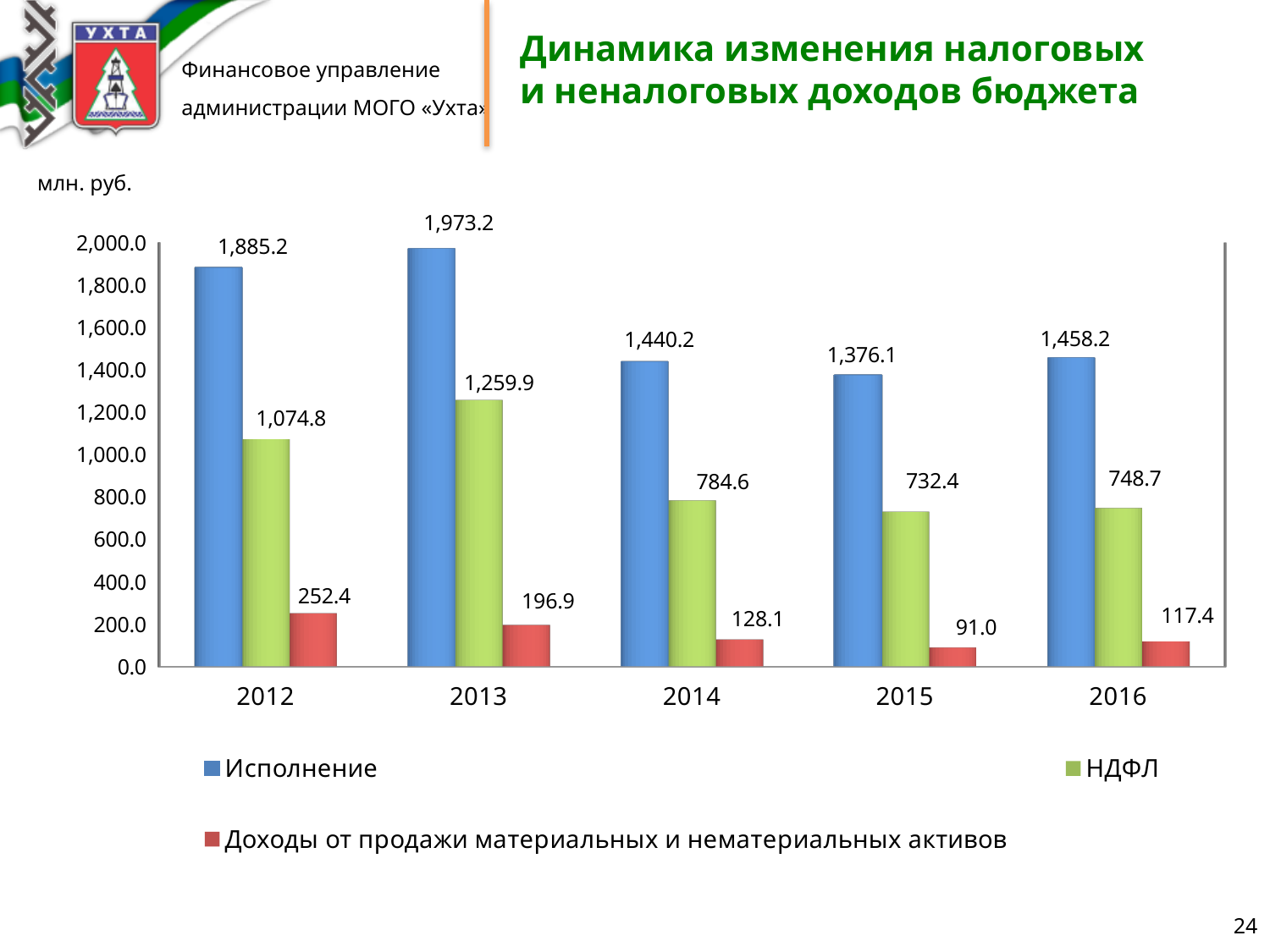
What is the value of Исполнение for 2013? 1,973.2 By how much did Доходы от продажи материальных и нематериальных активов fall from 2012 to 2016? 135.0 In which year is Исполнение the highest? 2013 What is the value of НДФЛ for 2015? 732.4 How many series does the legend list? 3 How many years are shown on the x axis? 5 What kind of chart is shown on the slide? Bar chart What unit is indicated for the values on the chart? млн. руб. What is the value of Доходы от продажи материальных и нематериальных активов for 2014? 128.1 What is the difference between Исполнение in 2013 and in 2012? 88.0 In which year is Доходы от продажи материальных и нематериальных активов the lowest? 2015 Which is larger: НДФЛ in 2014 or НДФЛ in 2016? 2014